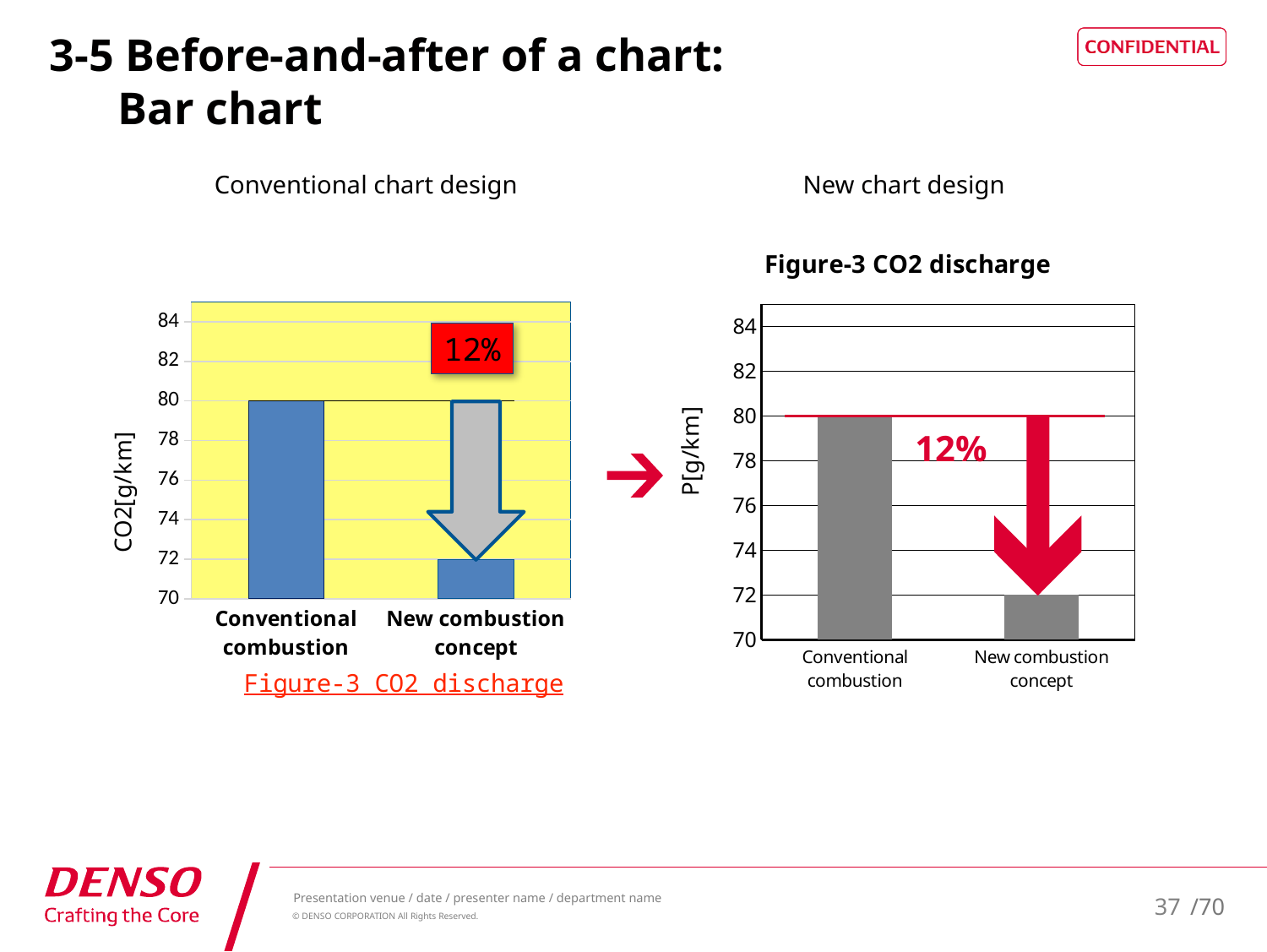
In the chart on the left (Conventional chart design), is the value for Conventional combustion larger or smaller than the value for New combustion concept? larger What is the title of the chart on the right (New chart design)? Figure-3 CO2 discharge How many categories are shown in the chart on the right (New chart design)? 2 In the chart on the left (Conventional chart design), what is the CO2 value for Conventional combustion? 80 What type of chart is shown on the right (New chart design)? Bar chart In the chart on the right (New chart design), is the value for New combustion concept greater or less than 76? less In the chart on the left (Conventional chart design), which category has the highest value? Conventional combustion In the chart on the right (New chart design), what is the difference between the Conventional combustion and New combustion concept values? 8 In the chart on the right (New chart design), what is the value for Conventional combustion? 80 In the chart on the right (New chart design), what is the value for New combustion concept? 72 In the chart on the right (New chart design), which category has the lowest value? New combustion concept In the chart on the left (Conventional chart design), what is the CO2 value for New combustion concept? 72